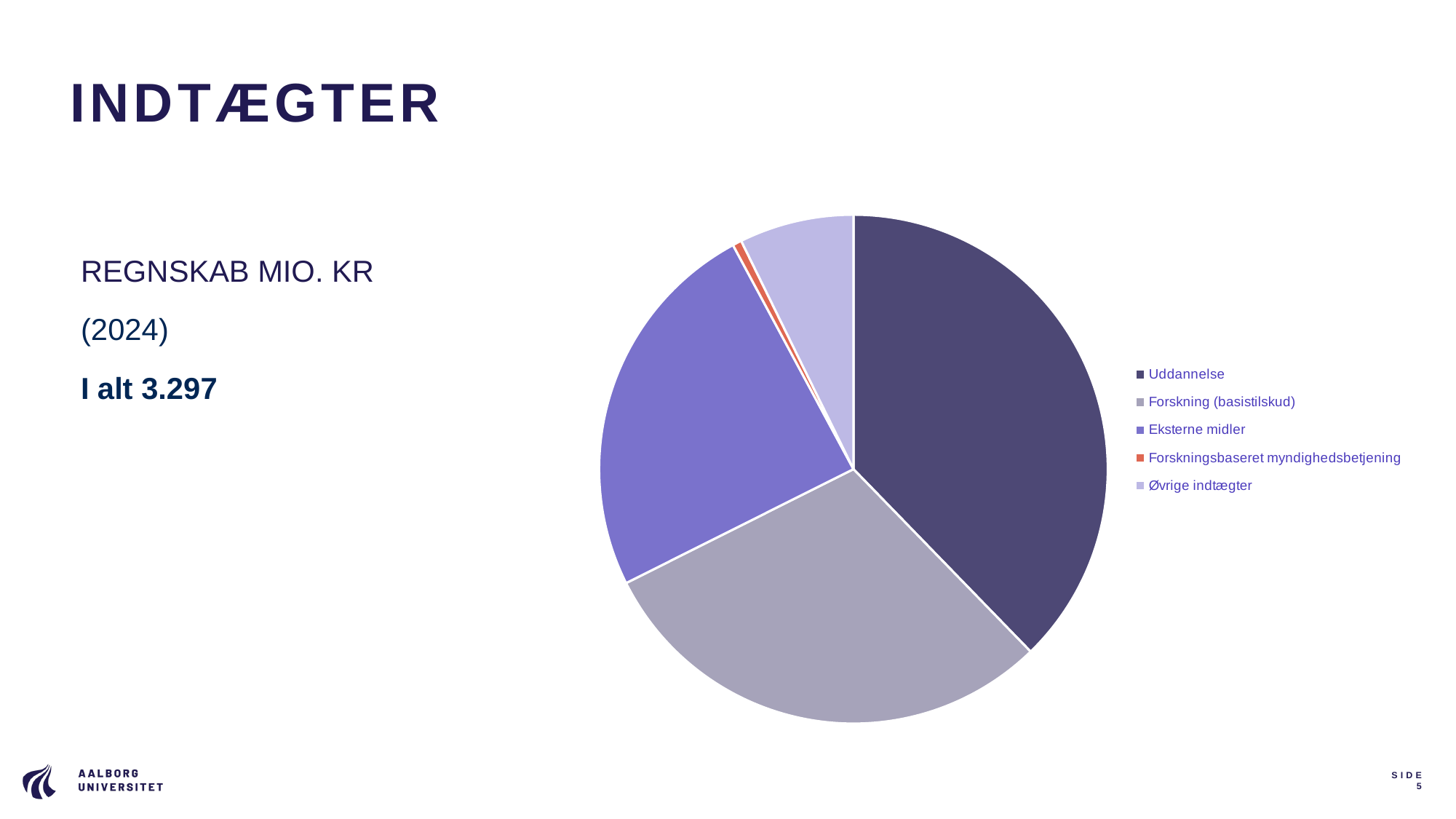
Which legend entry of the pie chart is shown in red/orange? Forskningsbaseret myndighedsbetjening How many entries does the legend of the pie chart list? 5 Which slice is larger, Forskning (basistilskud) or Eksterne midler? Forskning (basistilskud) Which category has the largest slice of the pie chart? Uddannelse Which slice is larger, Uddannelse or Øvrige indtægter? Uddannelse How many slices does the pie chart have? 5 What kind of chart is shown on the slide? Pie chart Which slice is larger, Eksterne midler or Forskningsbaseret myndighedsbetjening? Eksterne midler Which category has the smallest slice of the pie chart? Forskningsbaseret myndighedsbetjening What total amount is stated on the slide for the income shown in the pie chart? 3.297